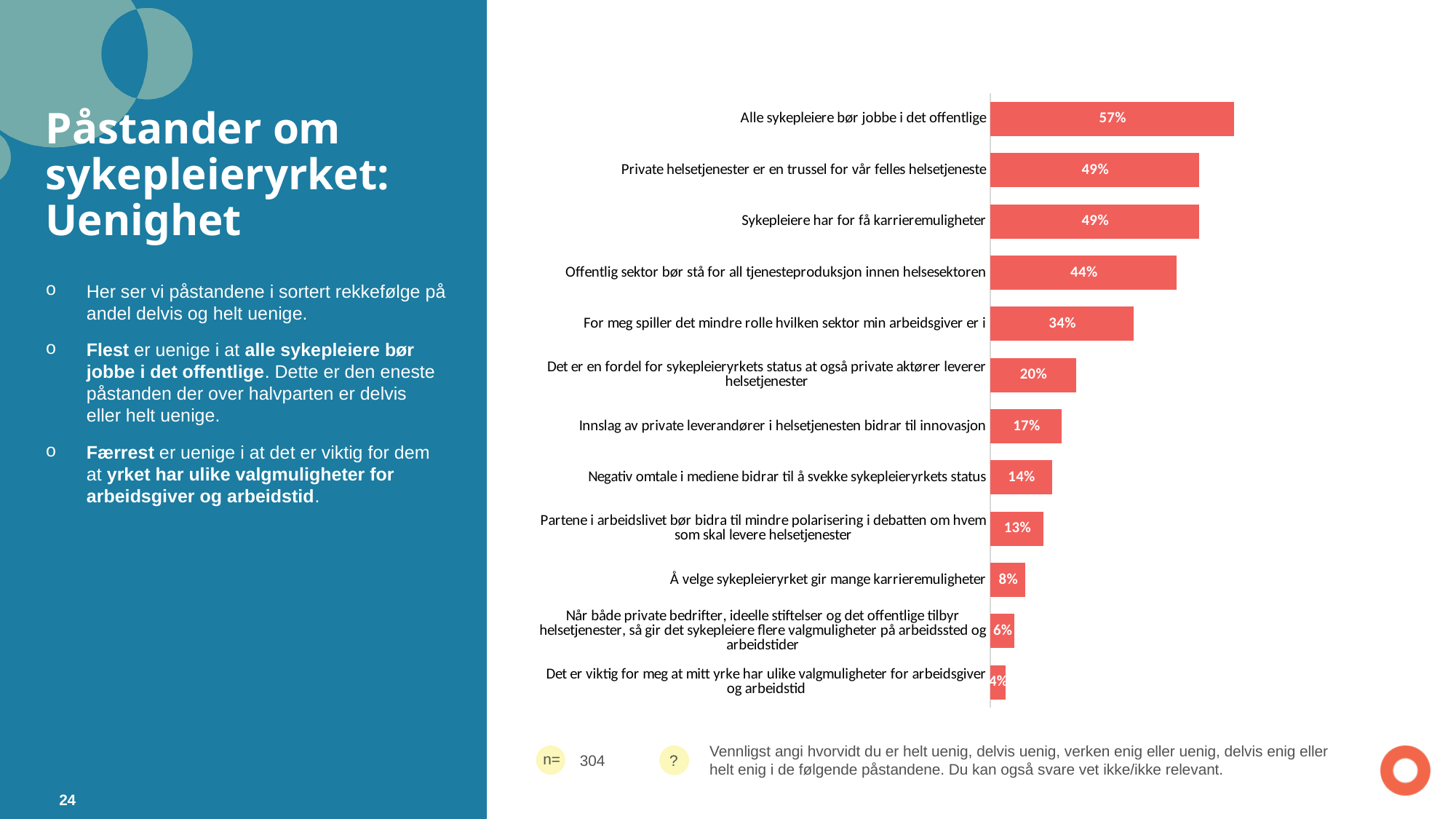
What is the value for "Å velge sykepleieryrket gir mange karrieremuligheter"? 8% How many statements (bars) are shown in the chart? 12 Which is larger: the value for "Sykepleiere har for få karrieremuligheter" or the value for "For meg spiller det mindre rolle hvilken sektor min arbeidsgiver er i"? Sykepleiere har for få karrieremuligheter What is the value for "For meg spiller det mindre rolle hvilken sektor min arbeidsgiver er i"? 34% Which statement has the lowest value in the chart? Det er viktig for meg at mitt yrke har ulike valgmuligheter for arbeidsgiver og arbeidstid What is the difference between the values for "Det er en fordel for sykepleieryrkets status at også private aktører leverer helsetjenester" and "Negativ omtale i mediene bidrar til å svekke sykepleieryrkets status"? 6 percentage points Which statement has the highest value in the chart? Alle sykepleiere bør jobbe i det offentlige What is the difference between the values for "Alle sykepleiere bør jobbe i det offentlige" and "Offentlig sektor bør stå for all tjenesteproduksjon innen helsesektoren"? 13 percentage points Do the values rise or fall going from the top bar to the bottom bar? Fall What kind of chart is shown on the slide? Bar chart What is the value for "Innslag av private leverandører i helsetjenesten bidrar til innovasjon"? 17% What is the value for "Alle sykepleiere bør jobbe i det offentlige"? 57%